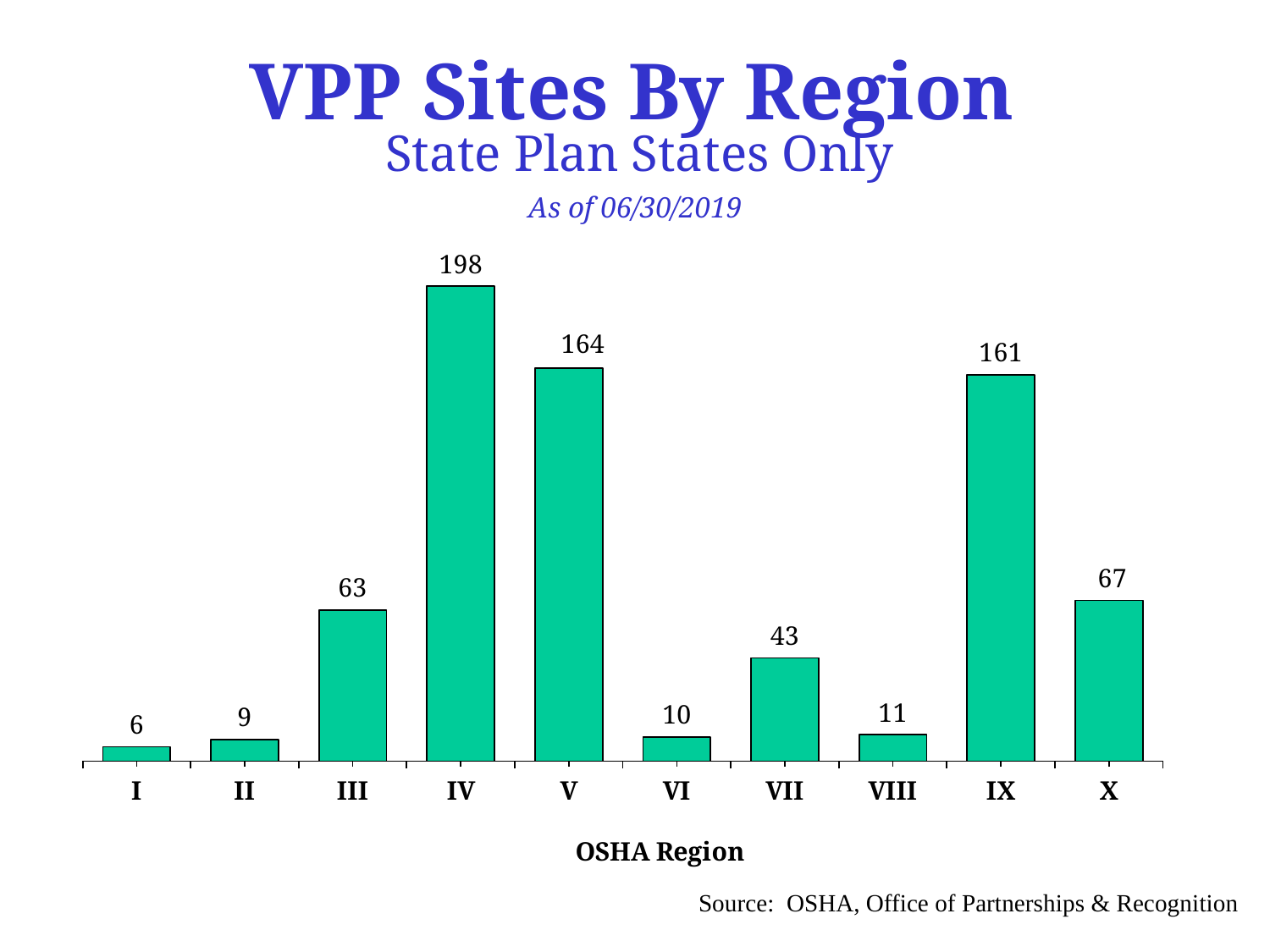
What kind of chart is shown on the slide? Bar chart How many OSHA regions are shown on the x axis? 10 What is the difference between the values for Region X and Region III? 4 Which has more VPP sites, Region VI or Region VIII? Region VIII Which OSHA region has the lowest number of VPP sites? I What is the value for OSHA Region IX? 161 Which has more VPP sites, Region V or Region IX? Region V Which OSHA region has the highest number of VPP sites? IV What is the x-axis title of the chart? OSHA Region How many VPP sites are shown for OSHA Region IV? 198 What is the value for OSHA Region VII? 43 What is the difference between the values for Region IV and Region V? 34